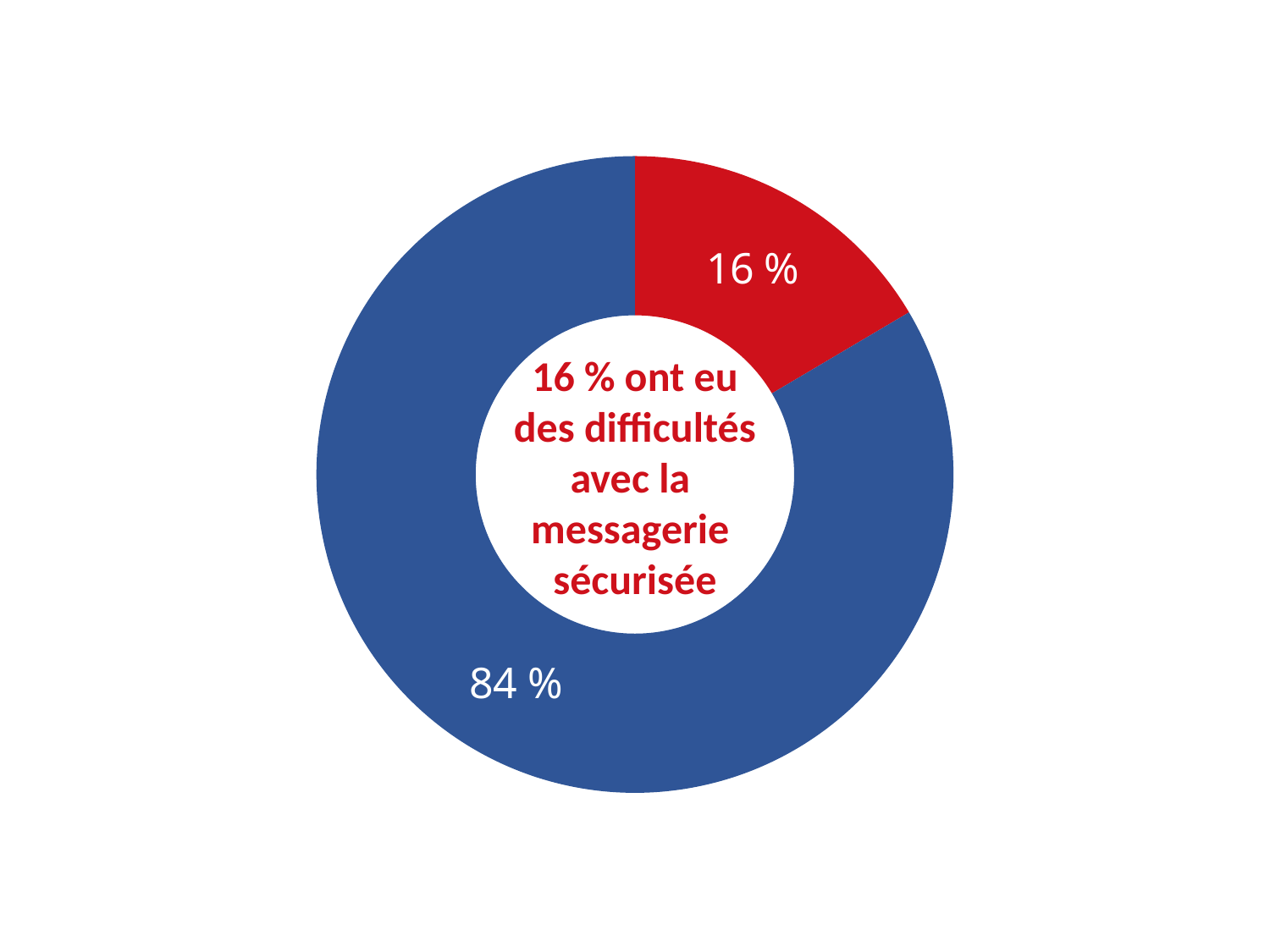
What kind of chart is shown on the slide? Doughnut chart What text is written in the centre of the doughnut chart? 16 % ont eu des difficultés avec la messagerie sécurisée Which slice of the doughnut chart is the smallest? The red slice (16 %) What value is shown on the red slice of the doughnut chart? 16 % What is the total of the two slices shown on the doughnut chart? 100 % Which slice of the doughnut chart is the largest? The blue slice (84 %) What value is shown on the blue slice of the doughnut chart? 84 % What colour is the slice representing those who had difficulties with the secure messaging? Red What share of the doughnut chart is taken by the red slice? 16 % Which is larger, the red slice or the blue slice of the doughnut chart? The blue slice What is the difference between the blue slice and the red slice of the doughnut chart? 68 % How many slices does the doughnut chart have? 2